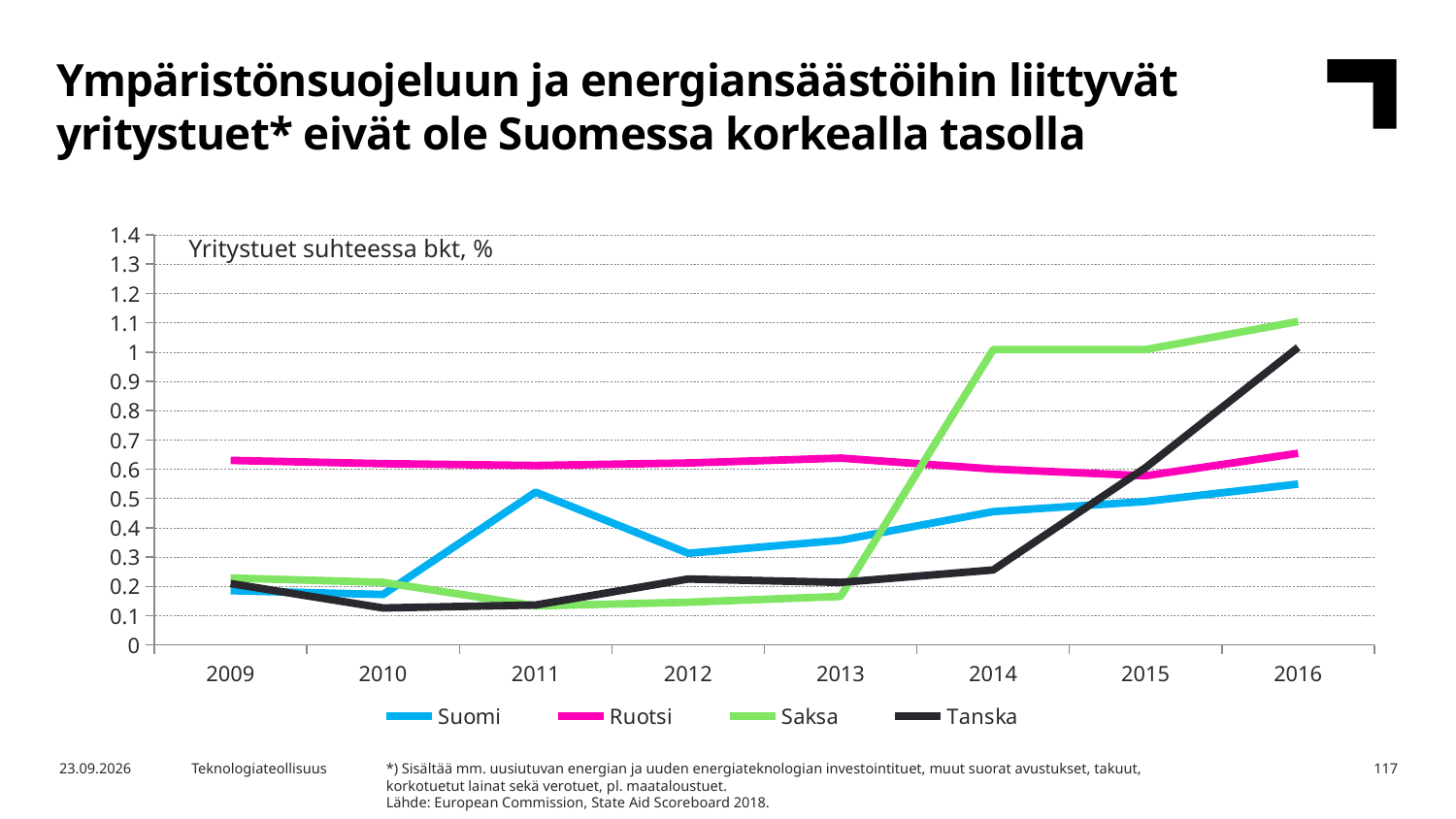
How many years are shown on the x axis? 8 Is the value for Tanska in 2010 greater or less than 0.2? less How many series does the legend list? 4 What is the title shown inside the chart area? Yritystuet suhteessa bkt, % Is the value for Suomi in 2011 greater or less than 0.4? greater Is the value for Ruotsi in 2013 greater or less than 0.6? greater Which country has the highest value in 2016? Saksa What kind of chart is shown on the slide? Line chart In 2009, which is larger: the value for Ruotsi or the value for Suomi? Ruotsi Which country has the lowest value in 2016? Suomi Does the value for Saksa rise or fall from 2013 to 2016? Rises